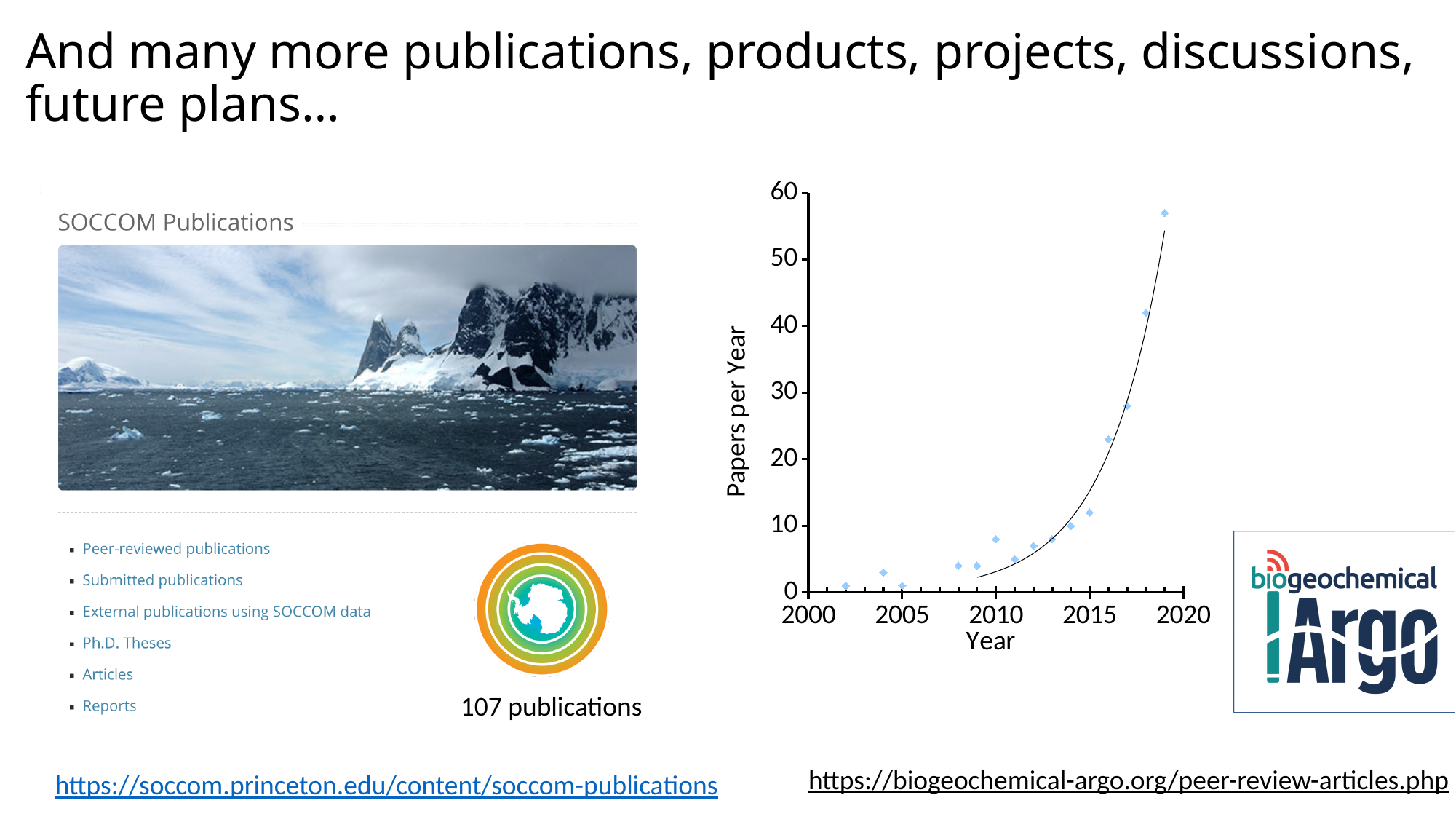
Is the value for 2018 greater or less than 30? greater Do the papers per year generally rise or fall as the year increases? rise What kind of chart is shown on the right of the slide? scatter plot Is the value for 2016 greater or less than 20? greater What is the label of the y axis of the chart? Papers per Year Is the value for 2019 greater or less than 50? greater Which year has the highest number of papers per year? 2019 Which year has more papers per year, 2018 or 2019? 2019 Which year has more papers per year, 2015 or 2016? 2016 What is the label of the x axis of the chart? Year